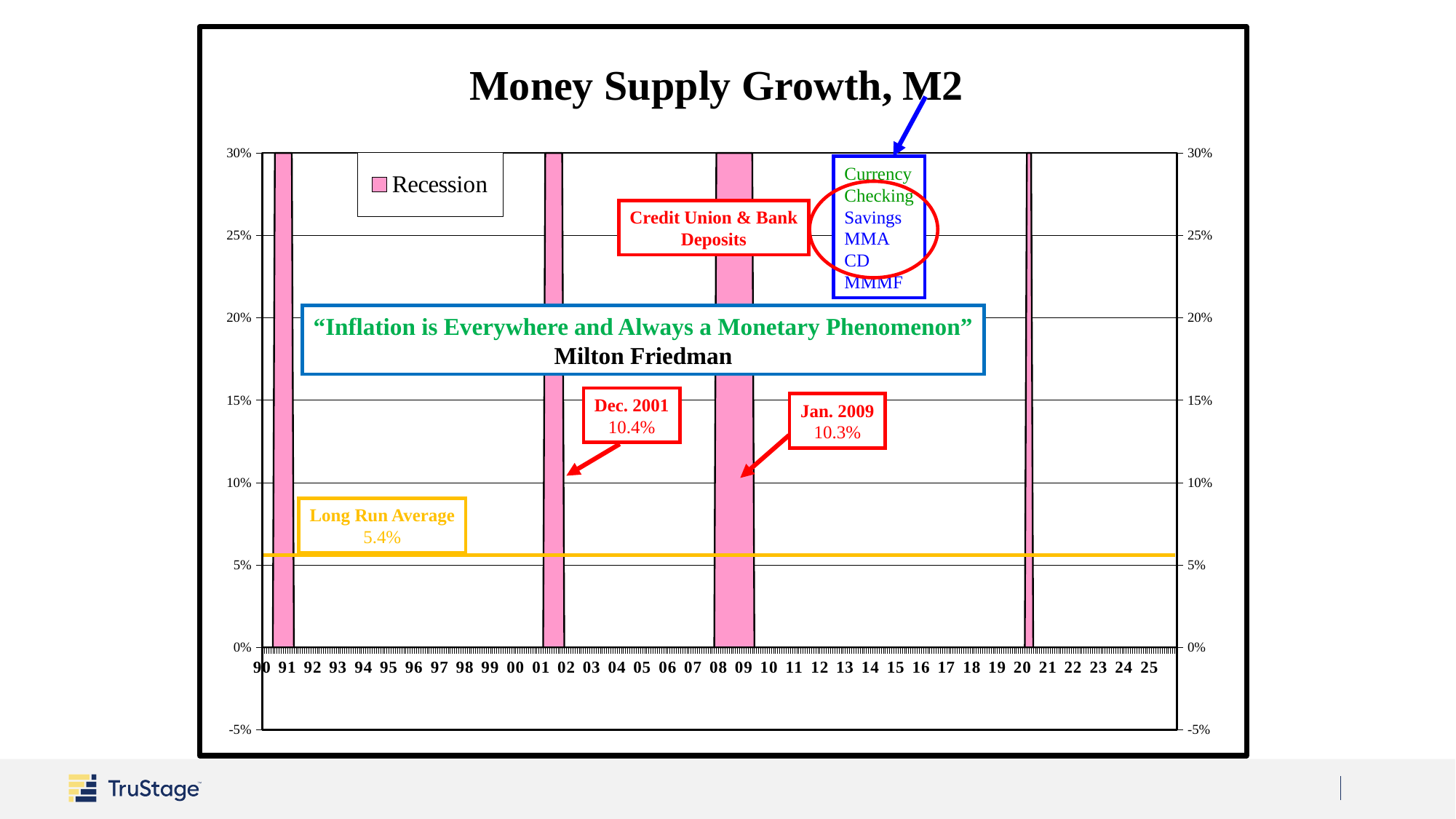
How many recession bars are shaded on the chart? 4 How much higher is the annotated Dec. 2001 value than the Long Run Average? 5.0% What is the only entry listed in the chart's legend? Recession What is the highest value shown on the vertical axis? 30% How many series does the legend list? 1 What is the difference between the annotated Dec. 2001 value and the Jan. 2009 value? 0.1% What M2 growth value is annotated for Dec. 2001? 10.4% What M2 growth value is annotated for Jan. 2009? 10.3% Which annotated value is larger, Dec. 2001 or Jan. 2009? Dec. 2001 What is the Long Run Average value annotated on the chart? 5.4% What is the title of the chart? Money Supply Growth, M2 Is the annotated Long Run Average greater or less than 10%? less